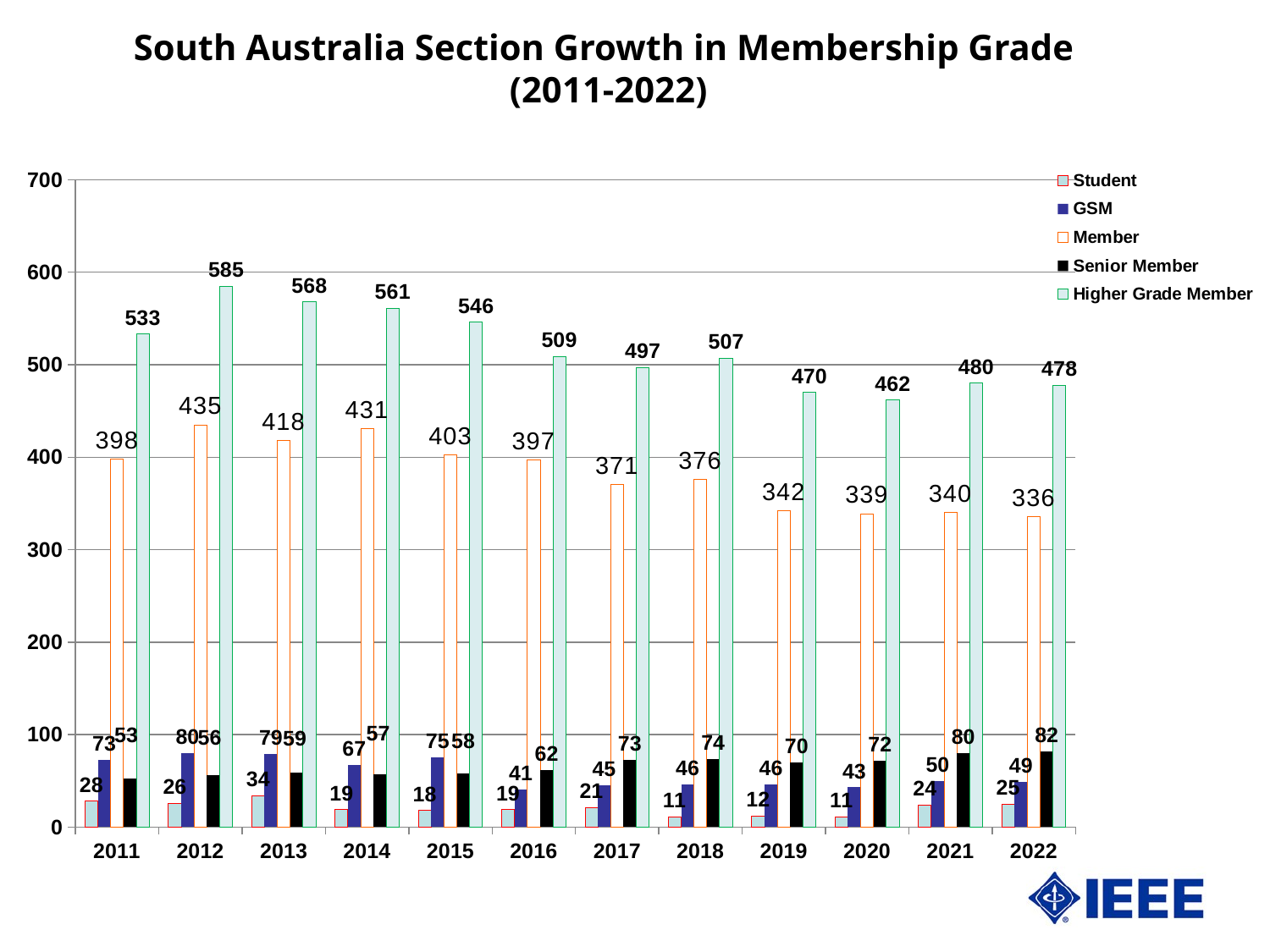
How many years are shown on the x axis? 12 What kind of chart is shown on the slide? bar chart How many series does the legend list? 5 Is the Higher Grade Member value for 2019 greater or less than 500? less What is the difference between the Member values for 2011 and 2022? 62 Which is larger, the GSM value for 2012 or the GSM value for 2021? 2012 What is the Senior Member value for 2016? 62 In which year is the Member value lowest? 2022 What is the Higher Grade Member value for 2022? 478 What is the Member value for 2012? 435 In which year is the Higher Grade Member value highest? 2012 Does the Member value generally rise or fall from 2012 to 2022? fall